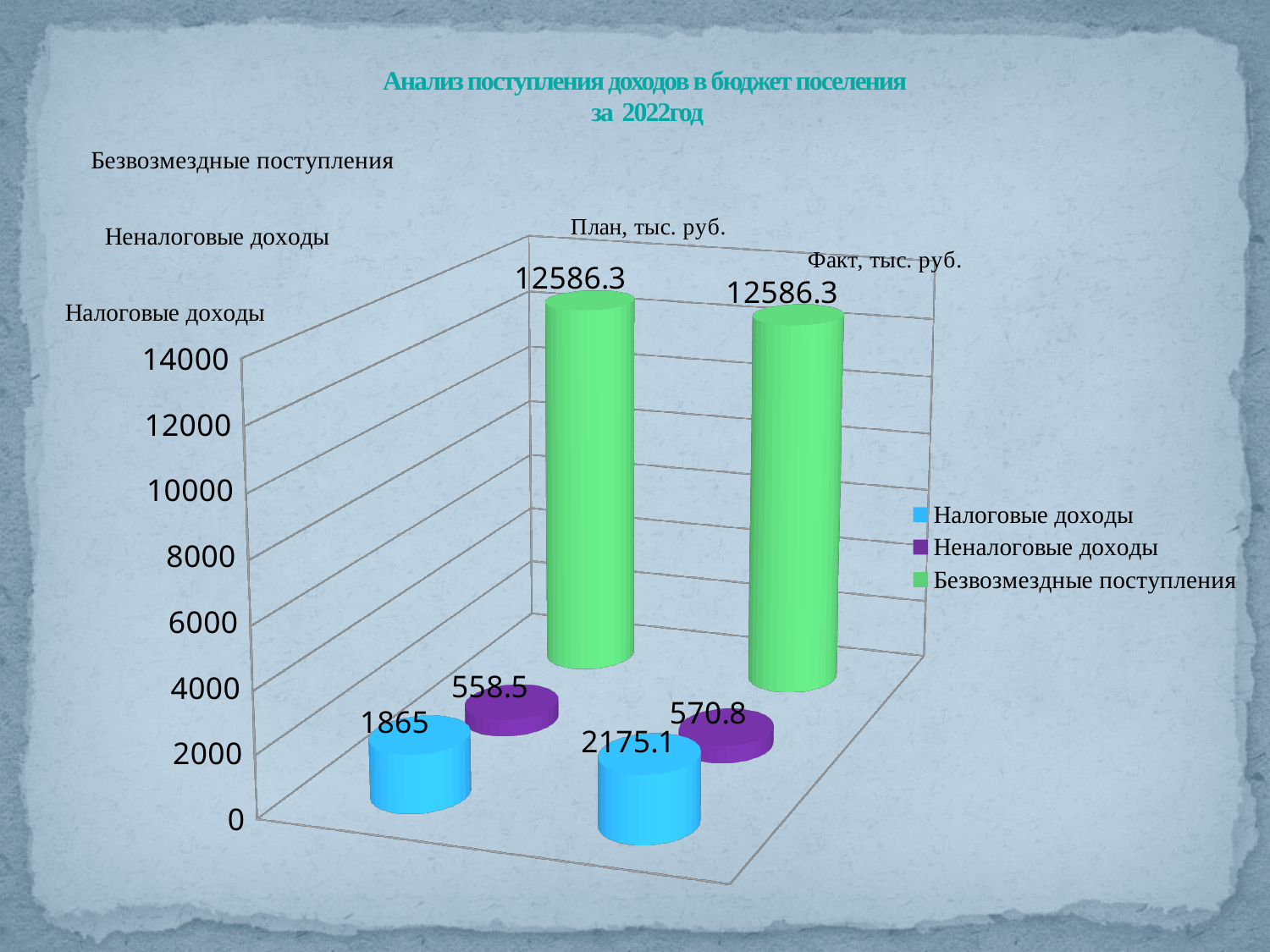
What is the title of the chart? Анализ поступления доходов в бюджет поселения за 2022год Which series has the lowest value for Факт, тыс. руб.? Неналоговые доходы What is the value of Неналоговые доходы for Факт, тыс. руб.? 570.8 What is the value of Налоговые доходы for Факт, тыс. руб.? 2175.1 Which series has the highest value for План, тыс. руб.? Безвозмездные поступления What is the value of Безвозмездные поступления for Факт, тыс. руб.? 12586.3 What is the difference between the Факт and План values for Налоговые доходы? 310.1 How many series does the legend list? 3 Which is larger for Неналоговые доходы: the План value or the Факт value? Факт, тыс. руб. What is the value of Налоговые доходы for План, тыс. руб.? 1865 What is the value of Неналоговые доходы for План, тыс. руб.? 558.5 What kind of chart is shown on the slide? Bar chart